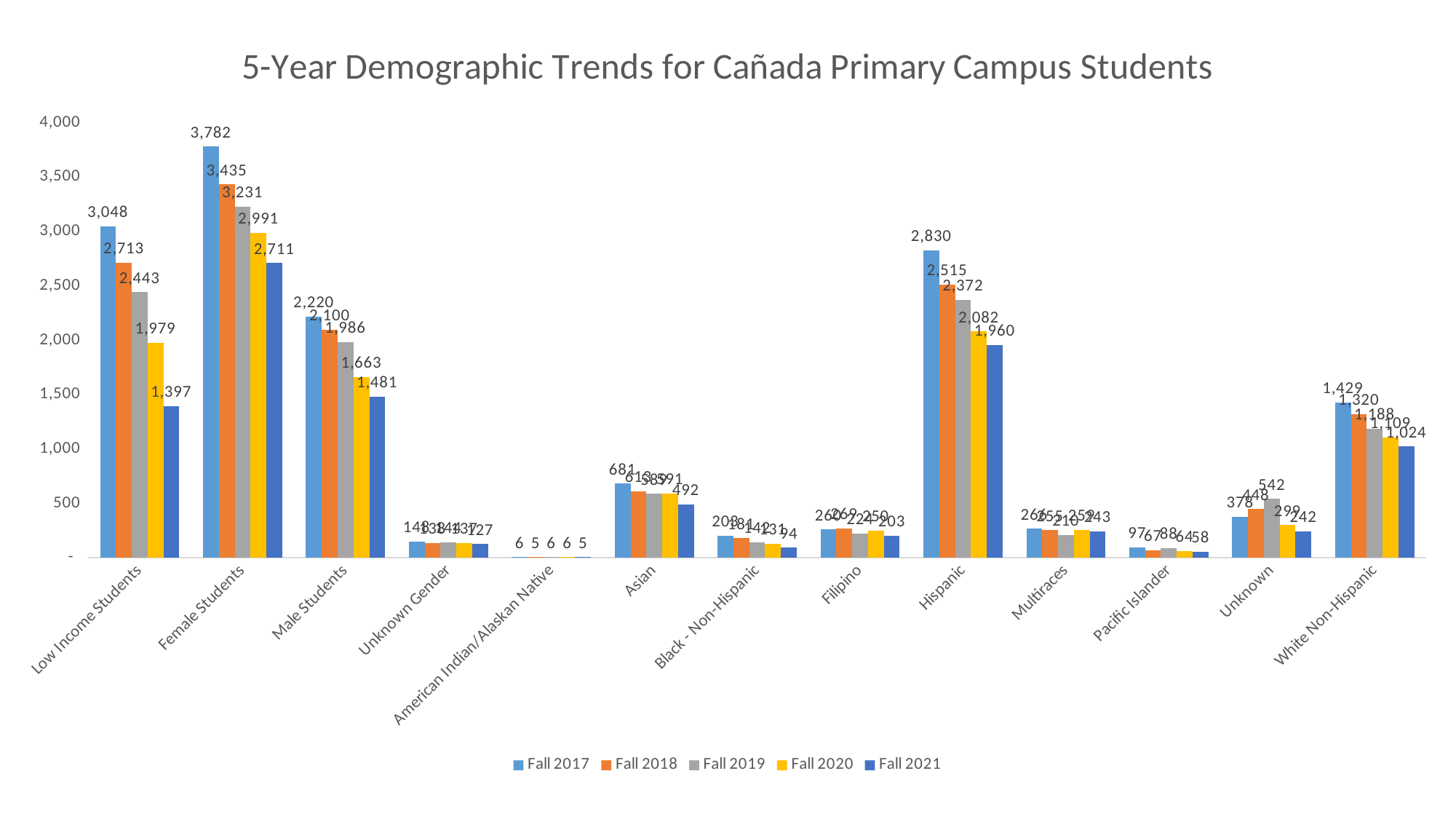
Do the values for Female Students rise or fall from Fall 2017 to Fall 2021? fall What is the value for White Non-Hispanic students in Fall 2019? 1,188 Which category has the highest value in Fall 2017? Female Students Which is larger: the Fall 2018 value for Male Students or the Fall 2018 value for Hispanic students? Hispanic students What is the value for Hispanic students in Fall 2021? 1,960 Which category has the lowest value in Fall 2021? American Indian/Alaskan Native What is the value for Low Income Students in Fall 2020? 1,979 Is the Fall 2019 value for Unknown greater or less than 500? greater How many series does the legend list? 5 What is the value for Female Students in Fall 2017? 3,782 What is the difference between the Fall 2017 and Fall 2021 values for Low Income Students? 1,651 How many categories are shown on the x axis? 13